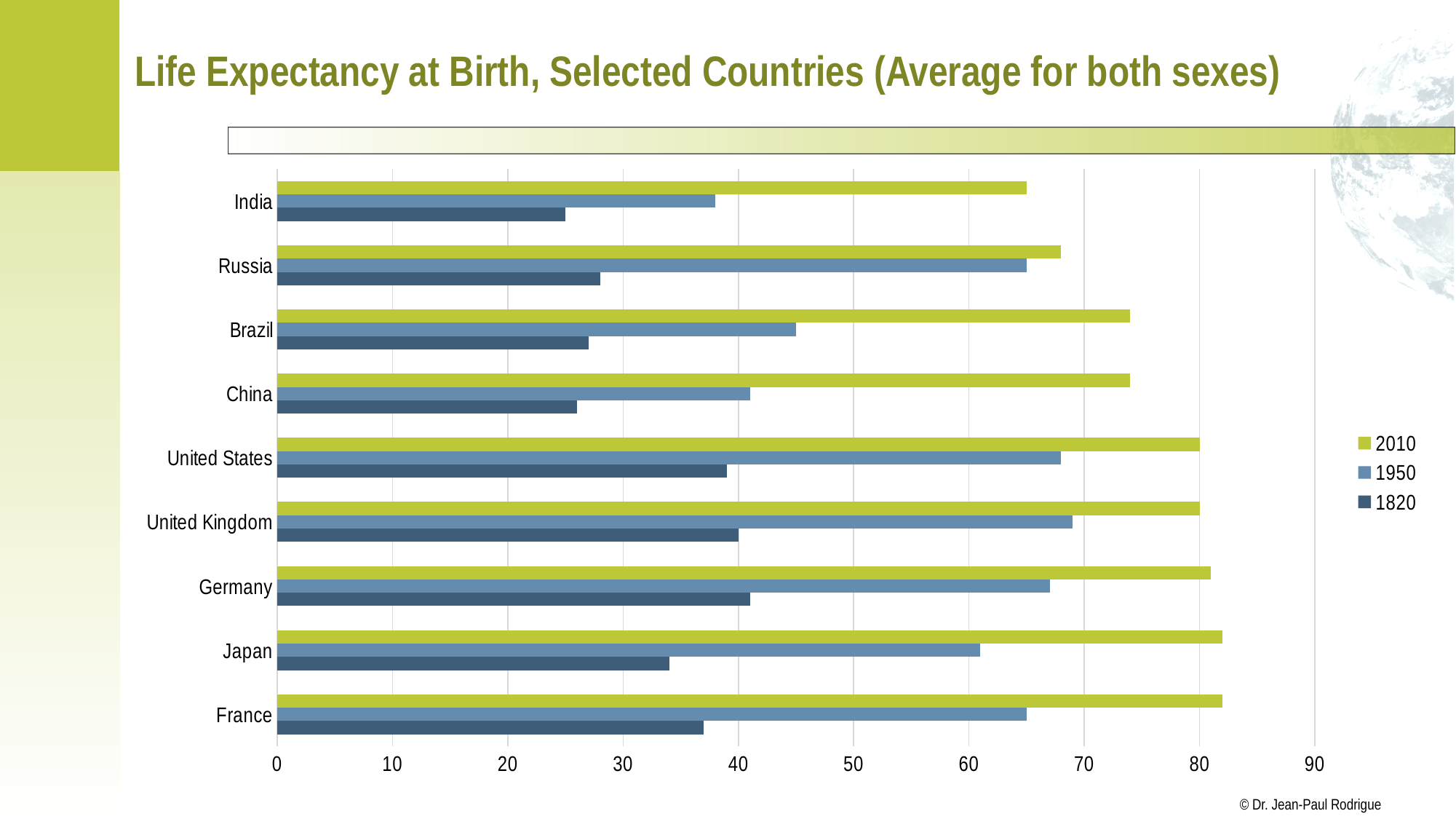
Which is larger, the 1820 value for Japan or the 1820 value for India? Japan What kind of chart is shown on the slide? bar chart Which country has the lowest value for 1950? India Is the value for Brazil in 1950 greater or less than 50? less Which years are listed in the legend? 2010, 1950, 1820 Is the value for India in 2010 greater or less than 60? greater Which is larger, the 1950 value for Russia or the 1950 value for Brazil? Russia How many countries are shown on the chart? 9 How many series does the legend list? 3 Is the value for India in 1820 greater or less than 30? less What is the title of the chart? Life Expectancy at Birth, Selected Countries (Average for both sexes) Which country has the lowest value for 2010? India